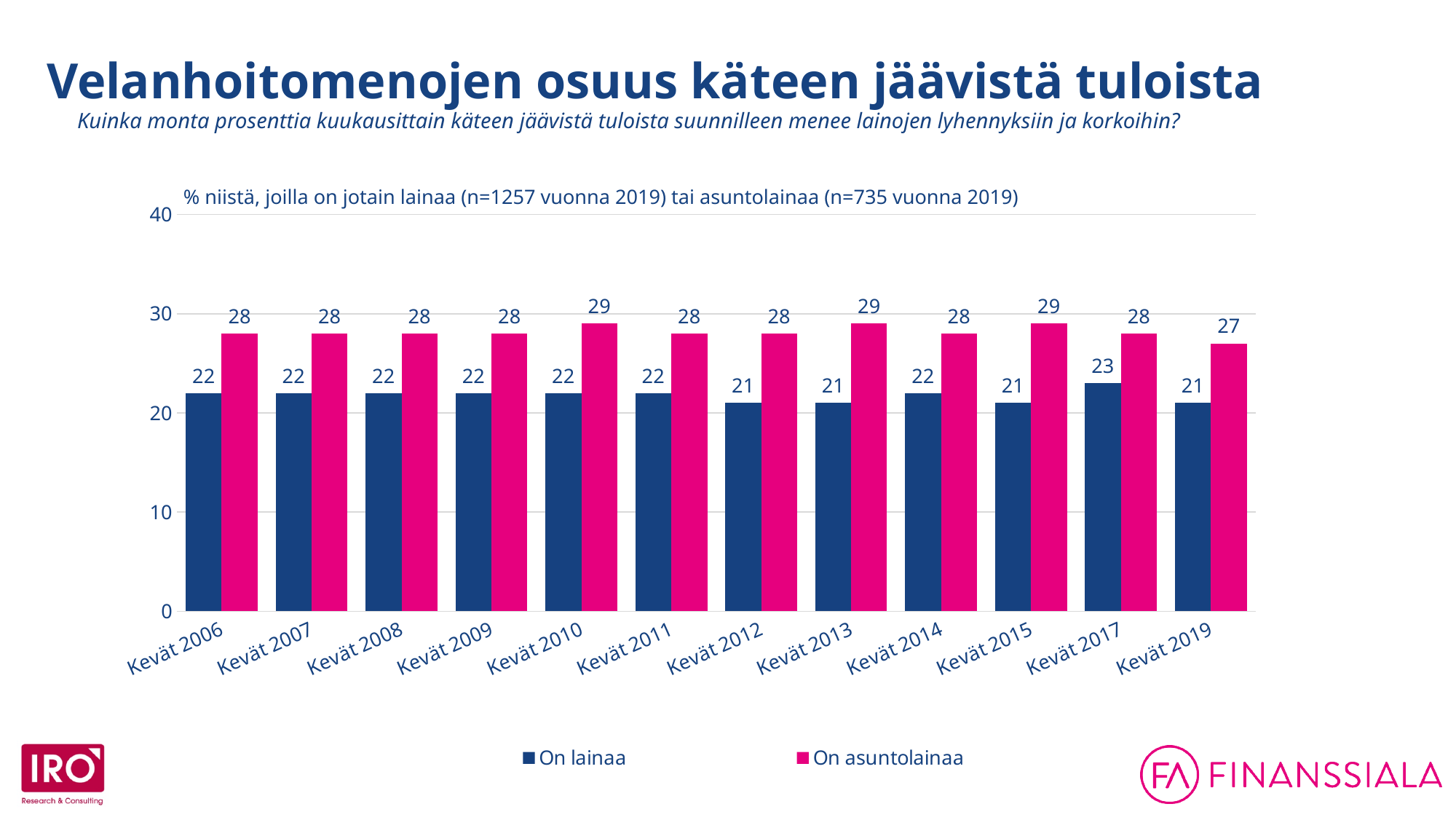
In which year does the "On lainaa" series reach its highest value? Kevät 2017 What is the value for "On asuntolainaa" in Kevät 2010? 29 In which year is the "On asuntolainaa" value lowest? Kevät 2019 How many series does the legend list? 2 How many years (categories) are shown on the x axis? 12 Which colour represents the "On asuntolainaa" series? Pink What is the value for "On asuntolainaa" in Kevät 2019? 27 What is the value for "On lainaa" in Kevät 2017? 23 What kind of chart is shown on the slide? Bar chart What is the value for "On lainaa" in Kevät 2012? 21 What is the difference between "On asuntolainaa" and "On lainaa" in Kevät 2015? 8 Which is larger in Kevät 2019: "On lainaa" or "On asuntolainaa"? On asuntolainaa